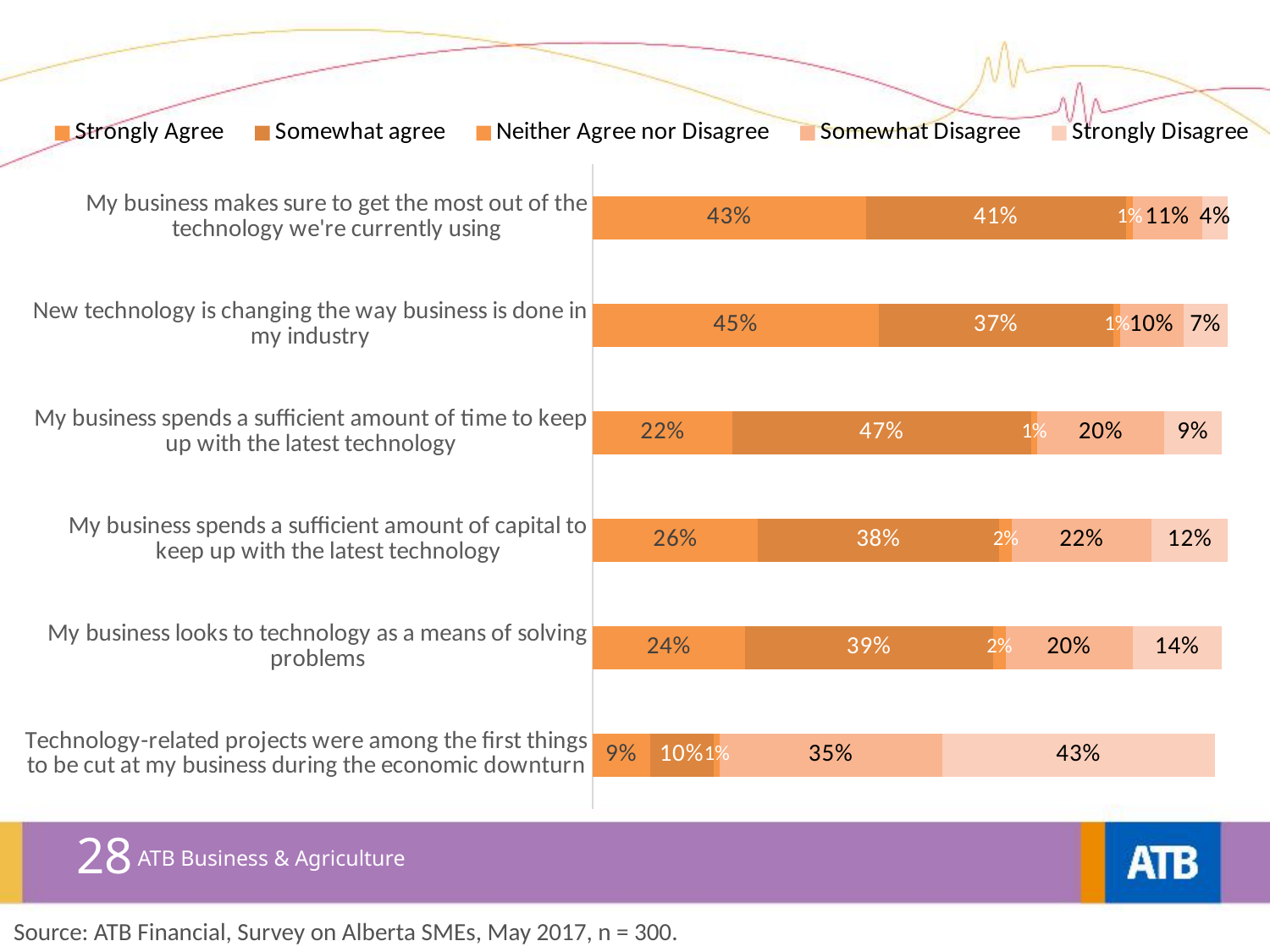
What percentage somewhat agree that their business spends a sufficient amount of time to keep up with the latest technology? 47% Which statement has the lowest Strongly Agree percentage? Technology-related projects were among the first things to be cut at my business during the economic downturn Which statement has the highest Strongly Agree percentage? New technology is changing the way business is done in my industry What is the combined Strongly Agree and Somewhat Agree percentage for 'My business makes sure to get the most out of the technology we're currently using'? 84% What is the difference between the Strongly Agree and Somewhat Agree percentages for 'My business spends a sufficient amount of time to keep up with the latest technology'? 25% What percentage somewhat disagree that their business spends a sufficient amount of capital to keep up with the latest technology? 22% How many response categories does the legend list? 5 What percentage strongly disagree that technology-related projects were among the first things to be cut at their business during the economic downturn? 43% What type of chart is shown on the slide? Stacked bar chart Which is larger: the Strongly Disagree percentage for 'My business looks to technology as a means of solving problems' or for 'My business spends a sufficient amount of capital to keep up with the latest technology'? My business looks to technology as a means of solving problems How many statements are shown in the chart? 6 What percentage of respondents strongly agree that new technology is changing the way business is done in their industry? 45%